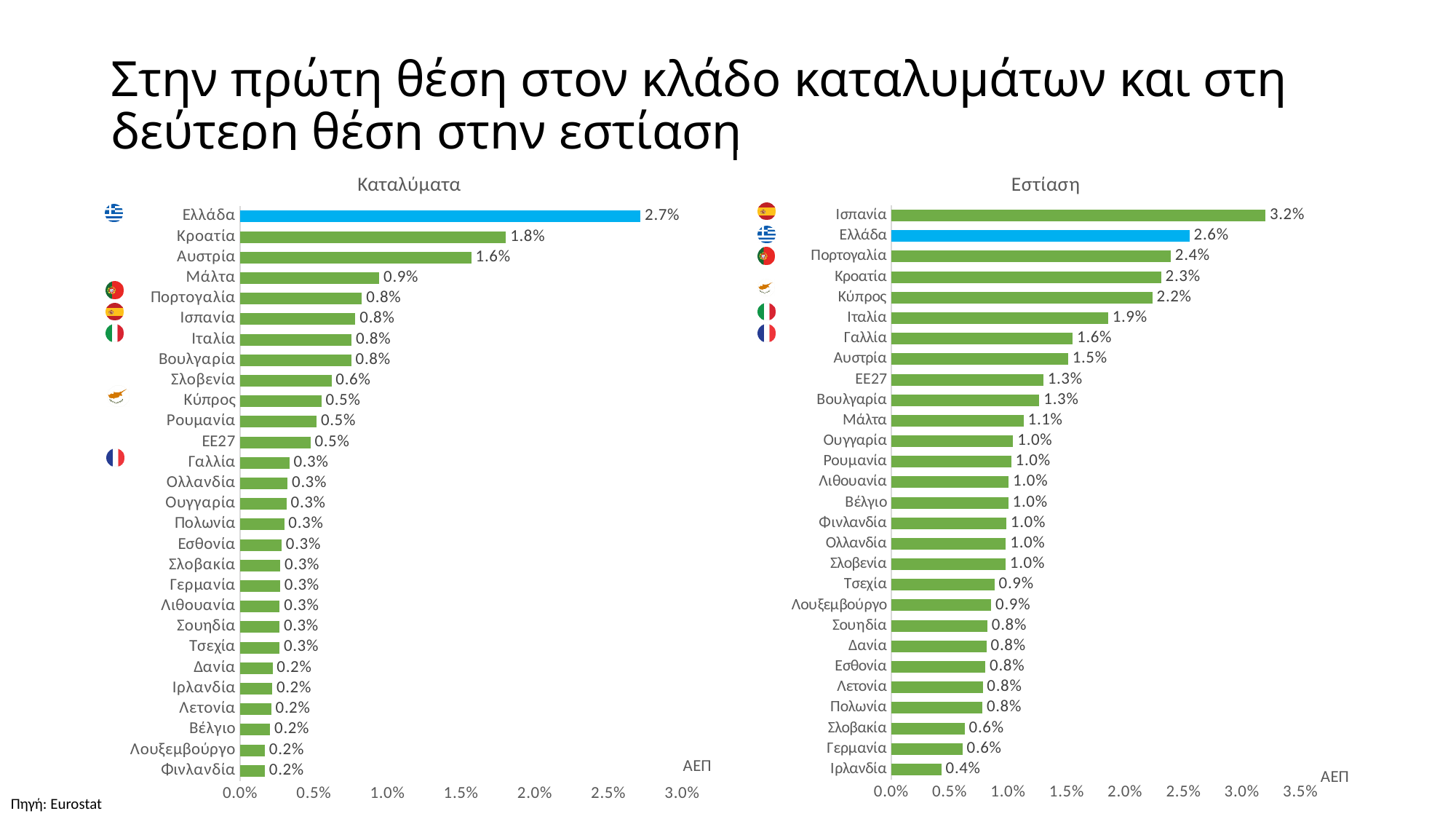
In the Εστίαση chart, what is the value for Ελλάδα? 2.6% In the Εστίαση chart, what is the value for ΕΕ27? 1.3% In the Καταλύματα chart, what is the difference between Ελλάδα and Κροατία? 0.9% What type of chart is the Εστίαση chart? Bar chart In the Εστίαση chart, what is the difference between Ισπανία and Ελλάδα? 0.6% In the Εστίαση chart, which country has the lowest value? Ιρλανδία In the Καταλύματα chart, which bar is highlighted in blue? Ελλάδα In the Εστίαση chart, which country has the highest value? Ισπανία In the Καταλύματα chart, which is larger: Αυστρία or Μάλτα? Αυστρία How many countries/categories are shown in the Καταλύματα chart? 28 In the Καταλύματα chart, which country has the highest value? Ελλάδα In the Καταλύματα chart, what is the value for Ελλάδα? 2.7%